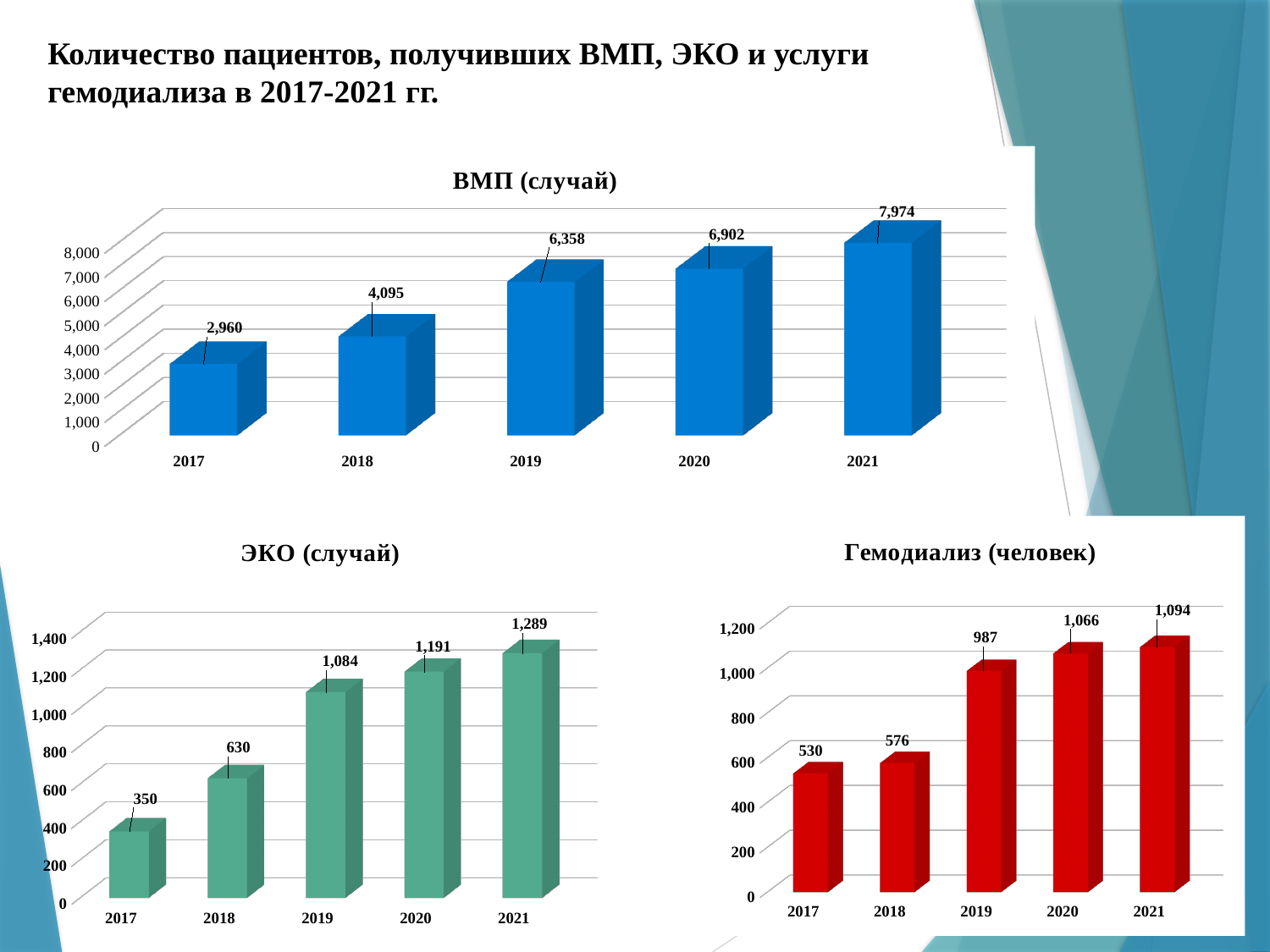
In the Гемодиализ (человек) chart, what is the value for 2020? 1,066 In the ЭКО (случай) chart, what is the value for 2018? 630 In the ЭКО (случай) chart, which year has the lowest value? 2017 In the Гемодиализ (человек) chart, what is the difference between the 2021 and 2020 values? 28 In the ЭКО (случай) chart, do the values rise or fall from 2017 to 2021? rise In the ЭКО (случай) chart, what is the difference between the 2020 and 2019 values? 107 In the ВМП (случай) chart, how many years are shown on the x axis? 5 In the Гемодиализ (человек) chart, which is larger, the value for 2018 or the value for 2019? 2019 In the ВМП (случай) chart, what is the value for 2019? 6,358 In the ВМП (случай) chart, what is the difference between the 2021 and 2017 values? 5,014 In the ВМП (случай) chart, which year has the highest value? 2021 What kind of chart is the Гемодиализ (человек) chart? bar chart